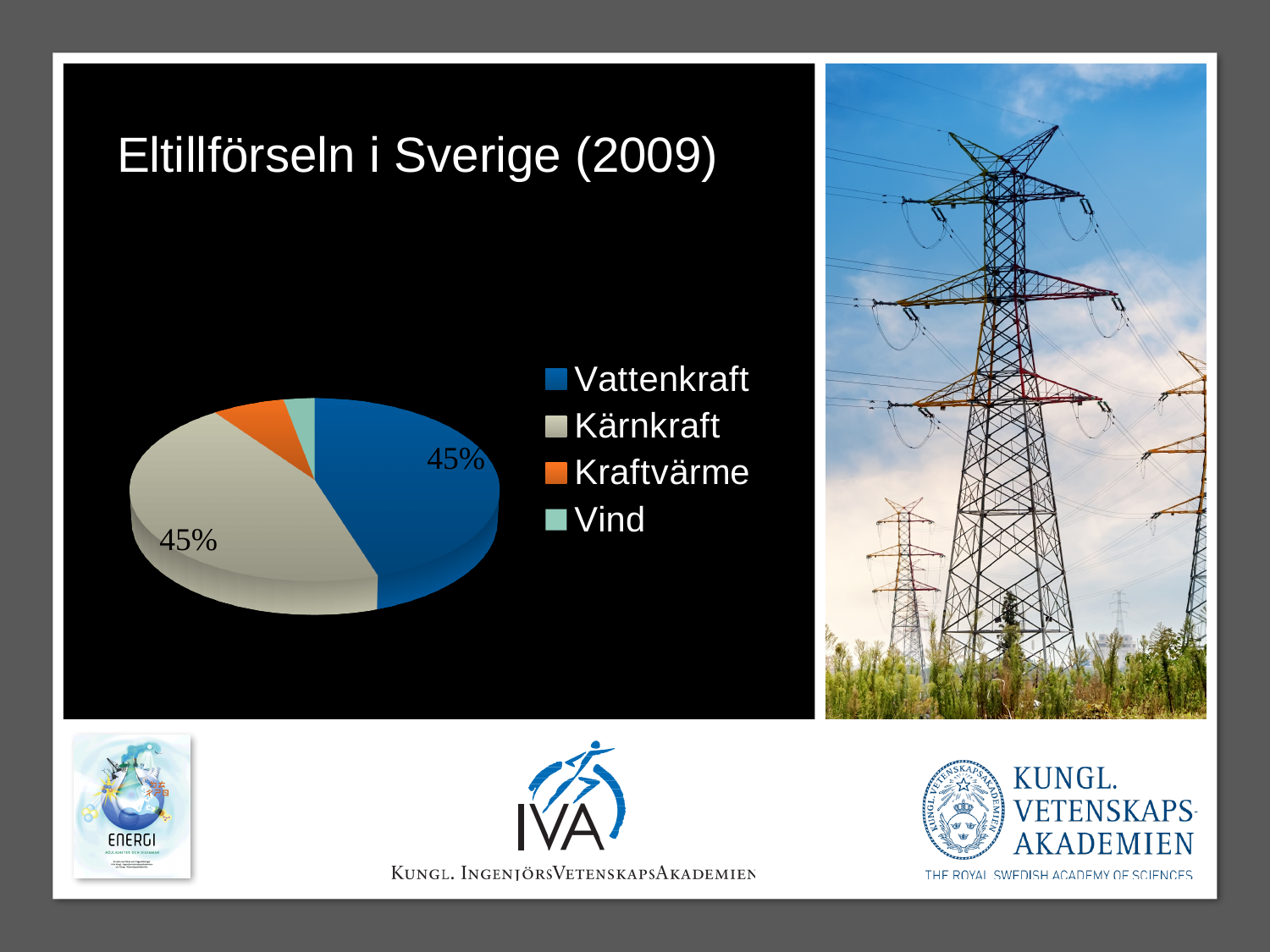
What kind of chart is shown on the slide? Pie chart What share of the pie is labelled for Kärnkraft? 45% What share of the pie is labelled for Vattenkraft? 45% What is the title of the chart on the slide? Eltillförseln i Sverige (2009) Which slice is larger, Kärnkraft or Vind? Kärnkraft Which slice is larger, Vattenkraft or Kraftvärme? Vattenkraft Which slice is larger, Kraftvärme or Vind? Kraftvärme Which category has the smallest slice of the pie? Vind Which category is shown in orange in the pie chart? Kraftvärme Is the share for Vattenkraft greater or less than 40%? greater How many categories does the pie chart's legend list? 4